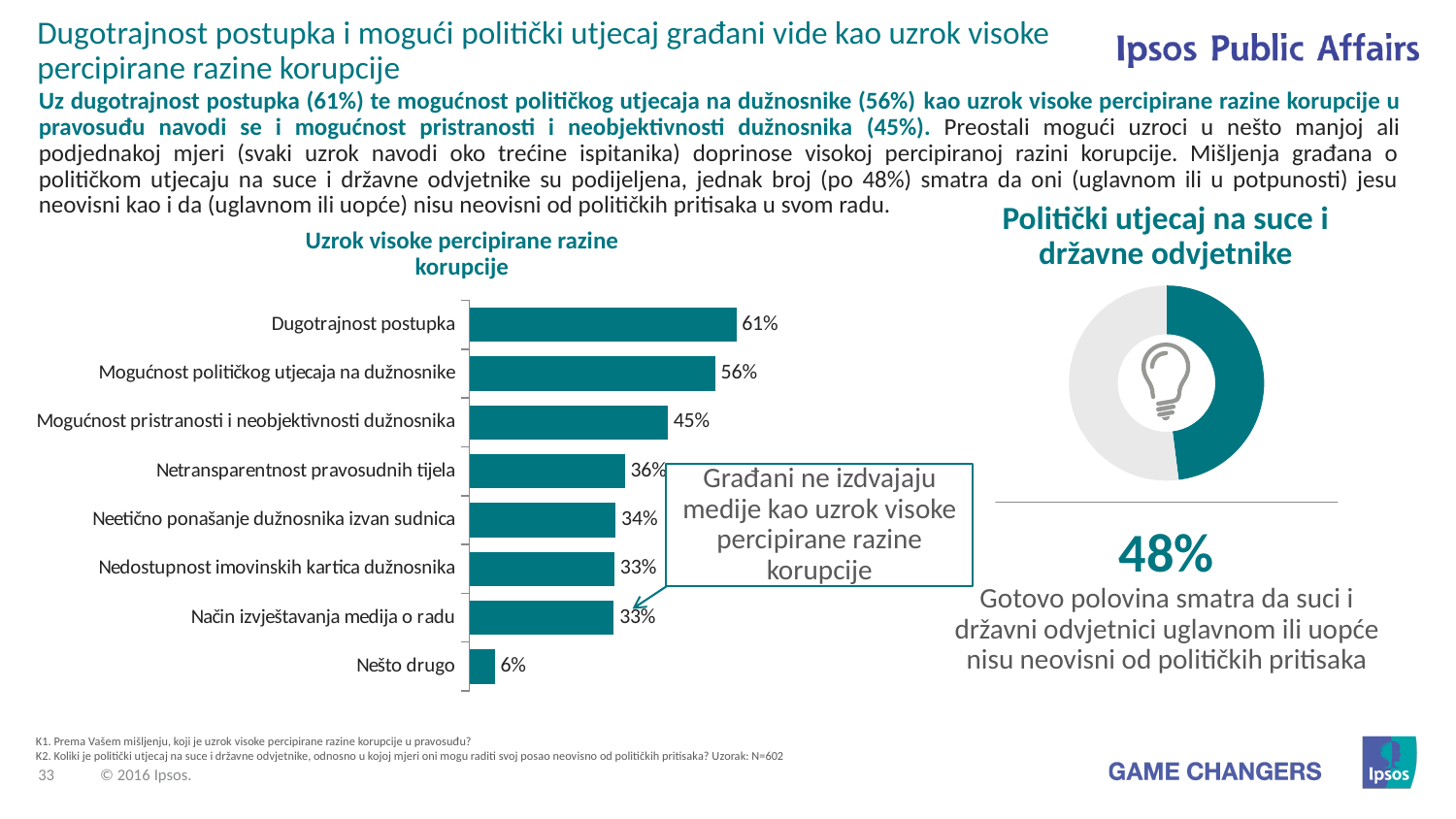
What kind of chart is 'Politički utjecaj na suce i državne odvjetnike'? Doughnut chart How many categories are shown in the chart 'Uzrok visoke percipirane razine korupcije'? 8 In the chart 'Uzrok visoke percipirane razine korupcije', which category has the highest value? Dugotrajnost postupka In the chart 'Uzrok visoke percipirane razine korupcije', what is the difference between 'Dugotrajnost postupka' and 'Mogućnost političkog utjecaja na dužnosnike'? 5% What percentage is highlighted below the chart 'Politički utjecaj na suce i državne odvjetnike'? 48% In the chart 'Uzrok visoke percipirane razine korupcije', which is larger: 'Neetično ponašanje dužnosnika izvan sudnica' or 'Mogućnost pristranosti i neobjektivnosti dužnosnika'? Mogućnost pristranosti i neobjektivnosti dužnosnika In the chart 'Uzrok visoke percipirane razine korupcije', what is the value for 'Mogućnost pristranosti i neobjektivnosti dužnosnika'? 45% In the chart 'Uzrok visoke percipirane razine korupcije', what is the value for 'Dugotrajnost postupka'? 61% What kind of chart is 'Uzrok visoke percipirane razine korupcije'? Bar chart In the chart 'Uzrok visoke percipirane razine korupcije', what is the value for 'Nedostupnost imovinskih kartica dužnosnika'? 33% In the chart 'Uzrok visoke percipirane razine korupcije', what is the difference between 'Netransparentnost pravosudnih tijela' and 'Nešto drugo'? 30% In the chart 'Uzrok visoke percipirane razine korupcije', which category has the lowest value? Nešto drugo